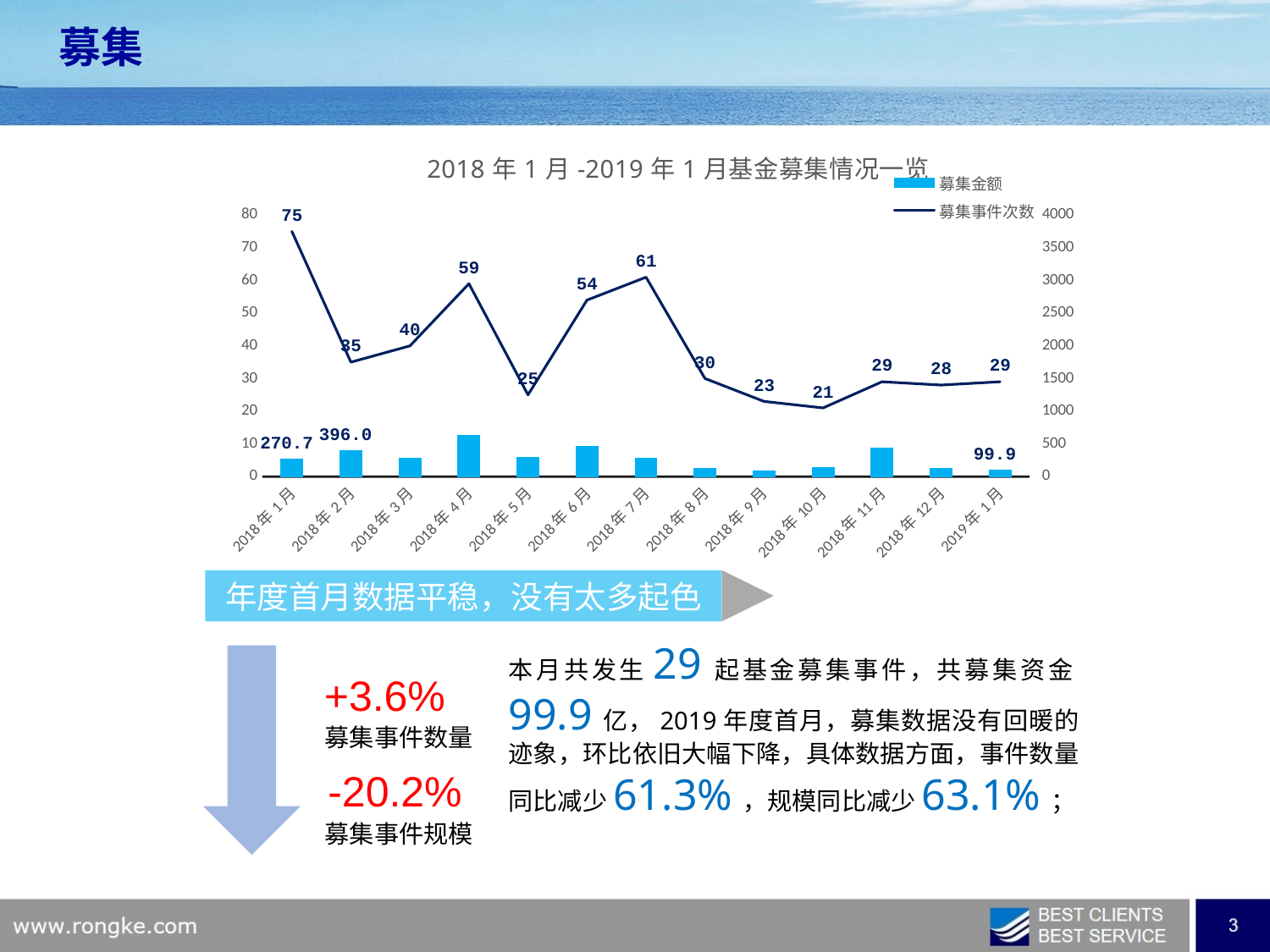
Which month has the highest 募集事件次数? 2018年1月 How many series does the chart legend list? 2 Is the 募集金额 value for 2018年9月 greater or less than 500? less What is the 募集金额 value for 2018年2月? 396.0 What is the 募集金额 value for 2019年1月? 99.9 Which month has a higher 募集事件次数, 2018年4月 or 2018年6月? 2018年4月 How many months are shown on the x axis of the chart? 13 What is the difference in 募集事件次数 between 2018年1月 and 2018年2月? 40 What is the difference in 募集金额 between 2018年1月 and 2019年1月? 170.8 What is the 募集事件次数 value for 2018年1月? 75 What is the 募集事件次数 value for 2018年7月? 61 Which month has the lowest 募集事件次数? 2018年10月